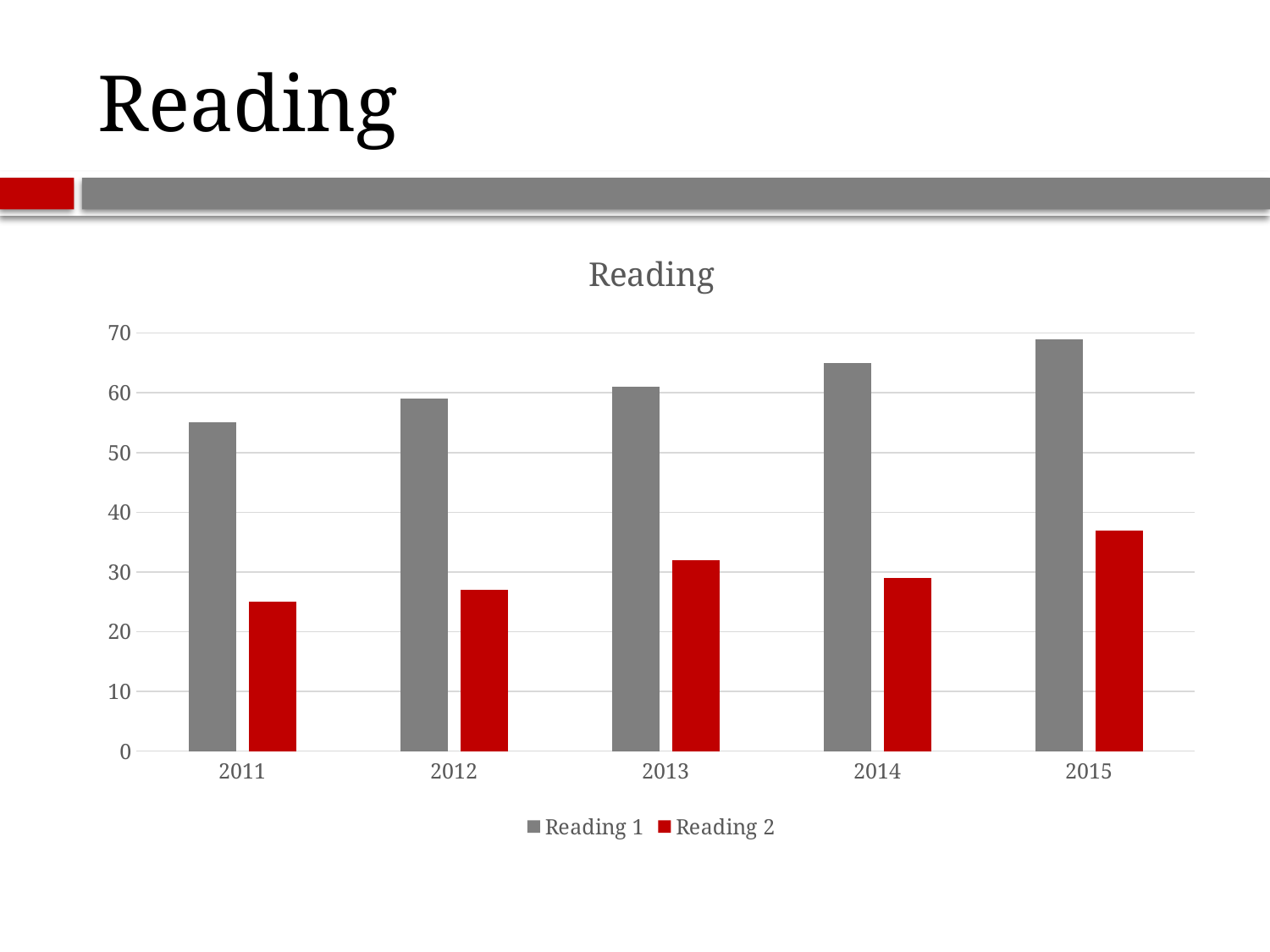
Is the Reading 2 value for 2011 greater or less than 30? less Is the Reading 1 value for 2011 greater or less than 50? greater What kind of chart is shown on the slide? Bar chart How many years are shown on the x axis? 5 In which year is the Reading 1 value highest? 2015 In which year is the Reading 2 value highest? 2015 Which is larger, the Reading 2 value for 2013 or for 2014? 2013 How many series does the legend list? 2 Is the Reading 2 value for 2015 greater or less than 30? greater What is the title of the chart? Reading Do the Reading 1 values rise or fall from 2011 to 2015? rise In which year is the Reading 2 value lowest? 2011